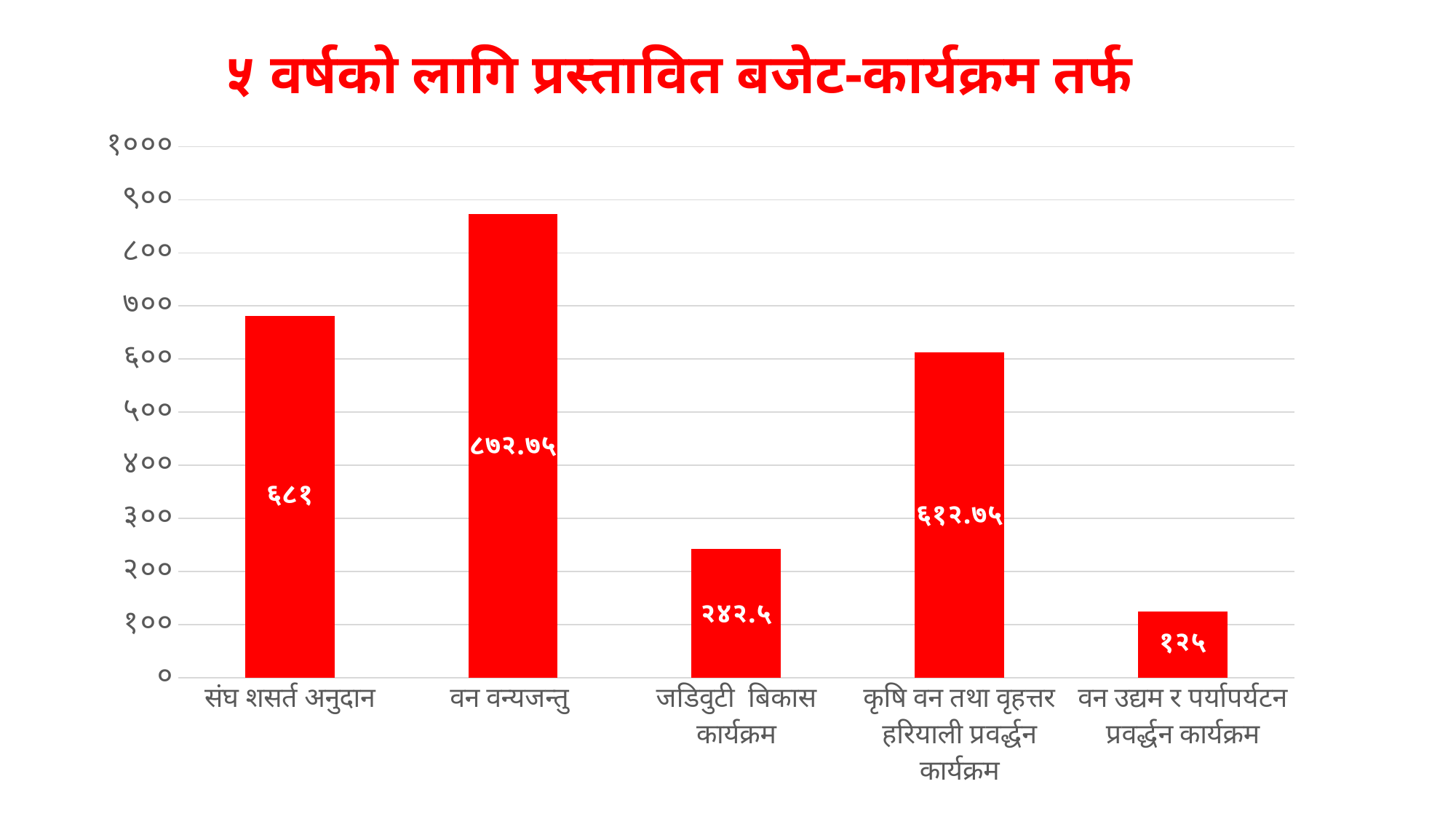
What is the value for संघ शसर्त अनुदान? ६८१ What is the difference between the values for वन वन्यजन्तु and संघ शसर्त अनुदान? १९१.७५ What is the value for वन उद्यम र पर्यापर्यटन प्रवर्द्धन कार्यक्रम? १२५ What is the value for जडिवुटी बिकास कार्यक्रम? २४२.५ Which is larger, the value for संघ शसर्त अनुदान or the value for कृषि वन तथा वृहत्तर हरियाली प्रवर्द्धन कार्यक्रम? संघ शसर्त अनुदान What is the value for वन वन्यजन्तु? ८७२.७५ How many categories are shown in the chart? 5 What kind of chart is shown on the slide? Bar chart What is the difference between the values for जडिवुटी बिकास कार्यक्रम and वन उद्यम र पर्यापर्यटन प्रवर्द्धन कार्यक्रम? ११७.५ Which category has the highest value? वन वन्यजन्तु What is the value for कृषि वन तथा वृहत्तर हरियाली प्रवर्द्धन कार्यक्रम? ६१२.७५ Which category has the lowest value? वन उद्यम र पर्यापर्यटन प्रवर्द्धन कार्यक्रम